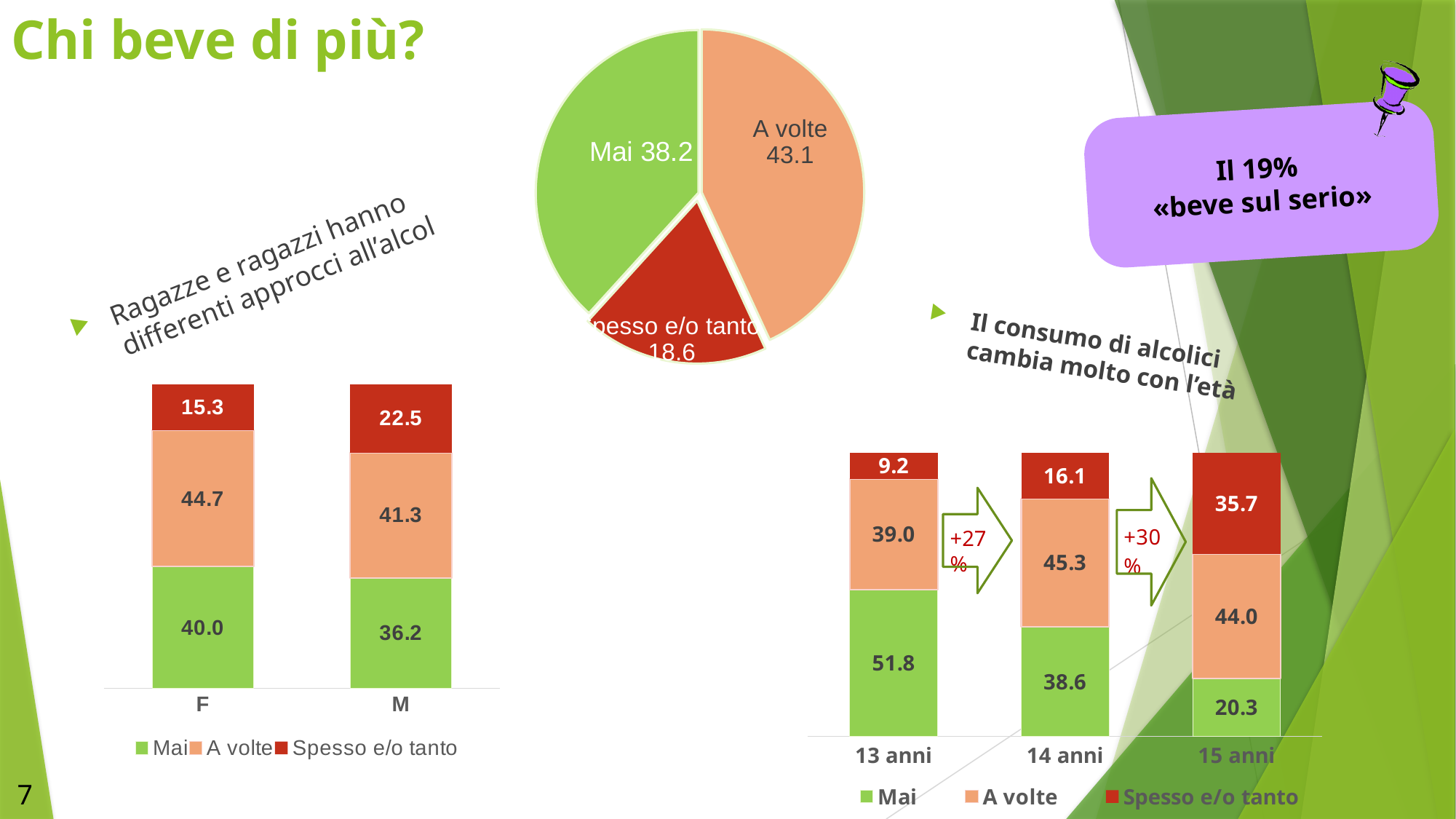
What kind of chart is the chart at the top centre of the slide? pie chart In the pie chart at the top centre, what is the value shown for Spesso e/o tanto? 18.6 In the pie chart at the top centre, which slice is the largest? A volte In the stacked bar chart on the right, what is the total of the 14 anni bar? 100.0 In the stacked bar chart on the left, what is the value of Spesso e/o tanto for M? 22.5 In the stacked bar chart on the right, which has the larger A volte value, 13 anni or 14 anni? 14 anni How many categories are shown on the x axis of the stacked bar chart on the left? 2 In the stacked bar chart on the left, what is the difference between the Mai values for F and M? 3.8 In the stacked bar chart on the right, which age group has the lowest Mai value? 15 anni In the stacked bar chart on the right, does the Spesso e/o tanto value rise or fall from 13 anni to 15 anni? rise In the stacked bar chart on the right, what is the Mai value for 15 anni? 20.3 How many series does the legend of the stacked bar chart on the left list? 3